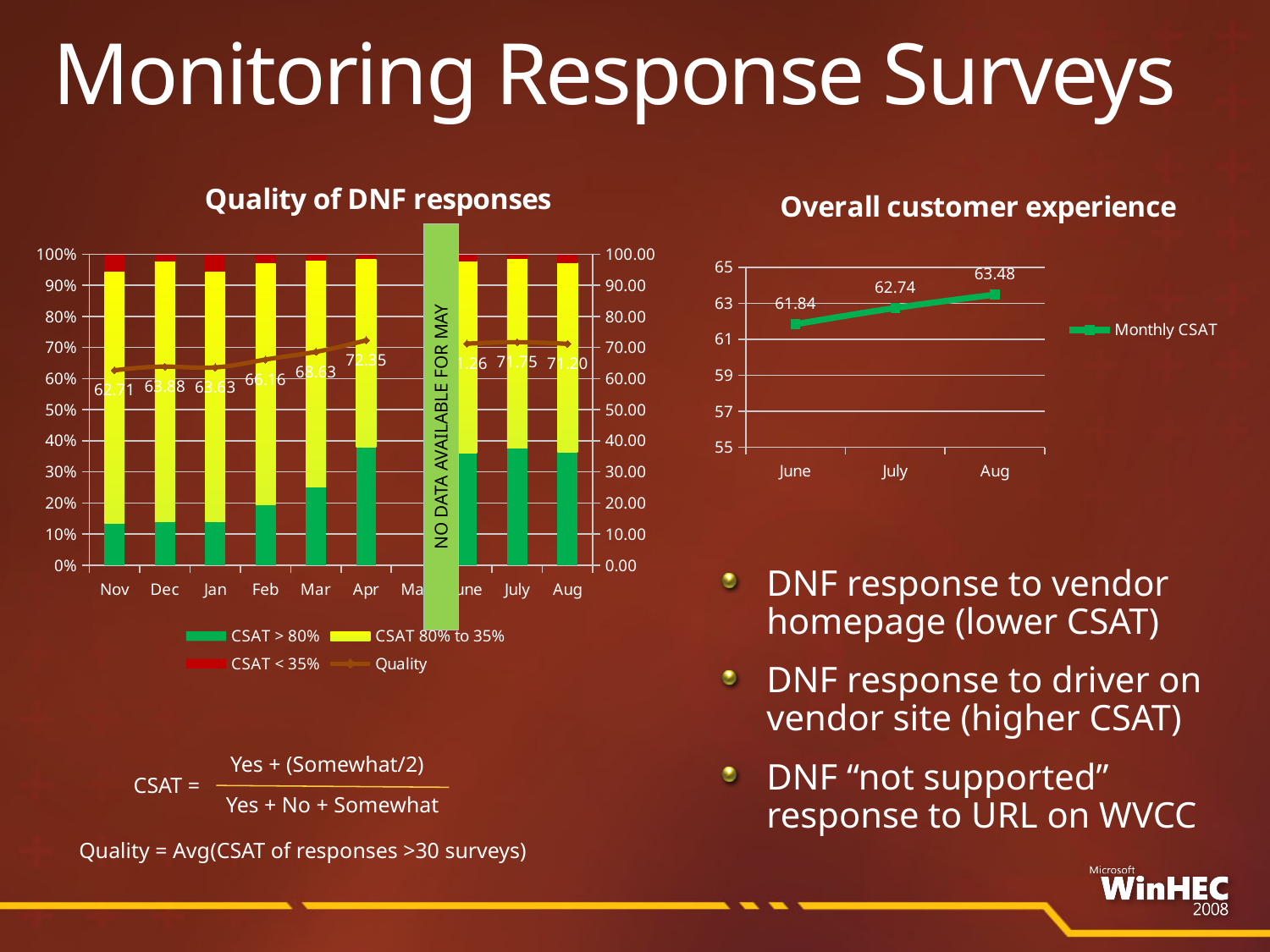
In the Quality of DNF responses chart, what is the Quality value for Nov? 62.71 In the Overall customer experience chart, which month has the highest Monthly CSAT? Aug In the Quality of DNF responses chart, which month is marked as having no data available? May In the Quality of DNF responses chart, which month has the lowest Quality value? Nov In the Quality of DNF responses chart, is the CSAT > 80% share for Apr greater or less than 30%? greater In the Overall customer experience chart, do the Monthly CSAT values rise or fall from June to Aug? rise In the Overall customer experience chart, what is the difference between the Aug and June Monthly CSAT values? 1.64 In the Overall customer experience chart, what is the Monthly CSAT value for Aug? 63.48 In the Overall customer experience chart, what is the Monthly CSAT value for June? 61.84 In the Quality of DNF responses chart, how many series does the legend list? 4 In the Quality of DNF responses chart, what is the Quality value for Apr? 72.35 In the Overall customer experience chart, how many months are plotted? 3